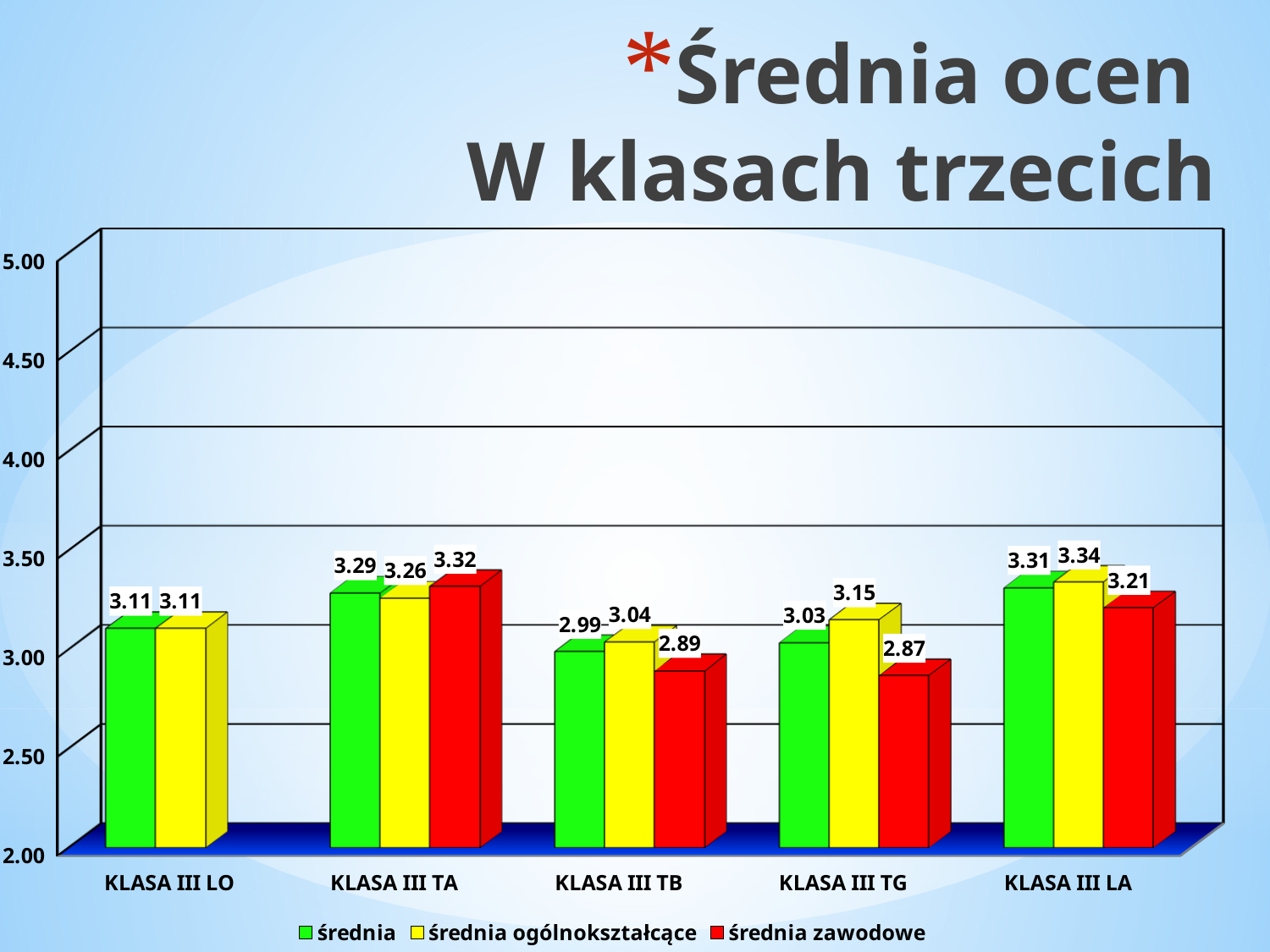
What is the difference between 'średnia ogólnokształcące' and 'średnia zawodowe' for KLASA III TG? 0.28 Which is larger for KLASA III TA: 'średnia ogólnokształcące' or 'średnia zawodowe'? średnia zawodowe What is the value of 'średnia ogólnokształcące' for KLASA III LA? 3.34 What is the value of 'średnia zawodowe' for KLASA III TG? 2.87 What type of chart is shown on the slide? bar chart Which class has the lowest 'średnia zawodowe' value? KLASA III TG Which class has the highest 'średnia' value? KLASA III LA What is the value of 'średnia' for KLASA III TB? 2.99 How many classes (categories) are shown on the x axis? 5 Is the 'średnia zawodowe' value for KLASA III TB greater or less than 3.00? less How many series does the legend list? 3 Which class has no 'średnia zawodowe' bar? KLASA III LO